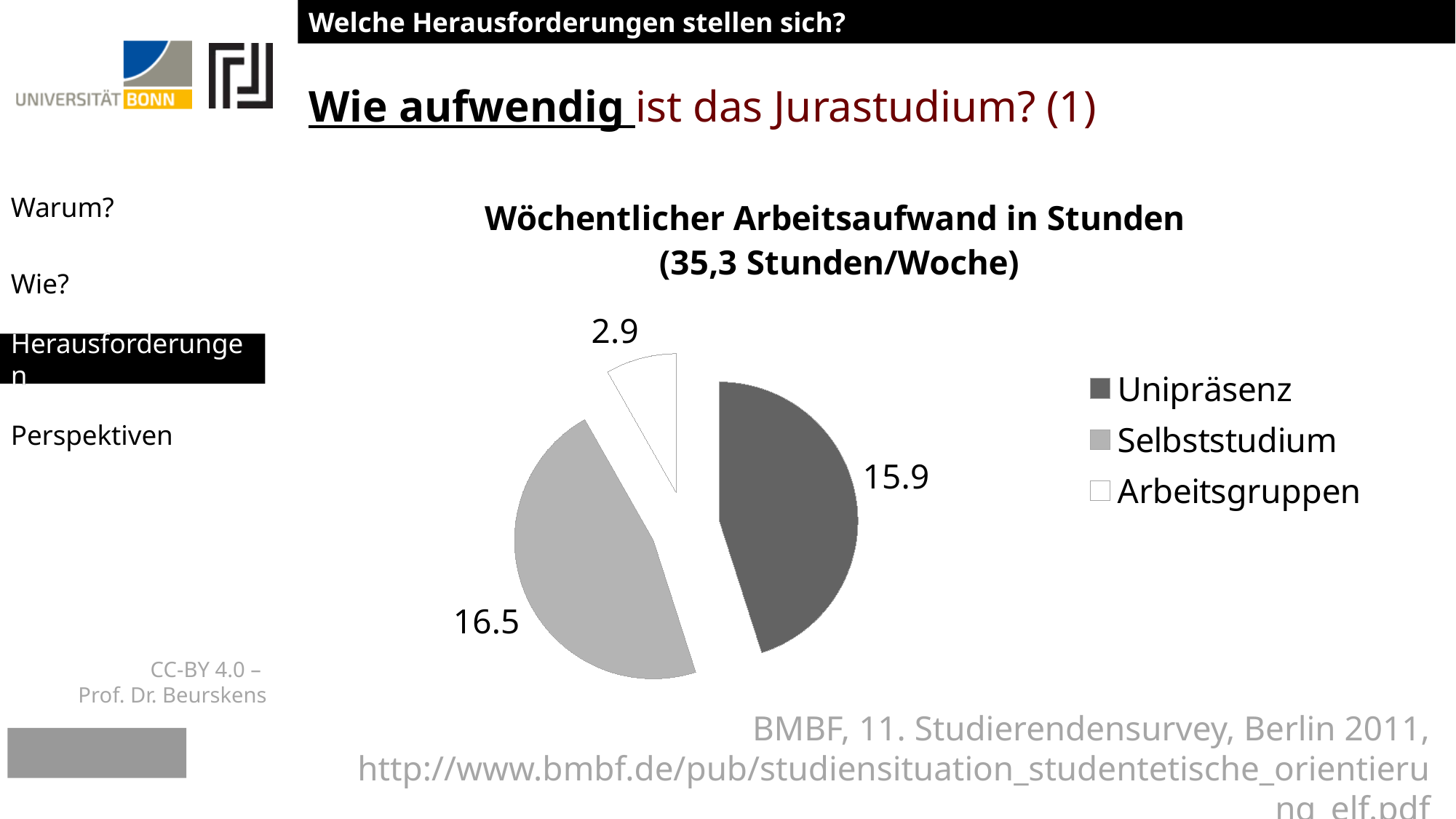
What is the total of all slices in the pie chart? 35.3 What is the value for Arbeitsgruppen? 2.9 What is the value for Unipräsenz? 15.9 Which is larger, the value for Unipräsenz or the value for Arbeitsgruppen? Unipräsenz What is the difference between the values for Selbststudium and Unipräsenz? 0.6 What type of chart is shown on the slide? pie chart How many slices does the pie chart have? 3 Which category has the largest value? Selbststudium What is the difference between the values for Unipräsenz and Arbeitsgruppen? 13.0 Which category has the smallest value? Arbeitsgruppen What is the value for Selbststudium? 16.5 What is the title of the chart? Wöchentlicher Arbeitsaufwand in Stunden (35,3 Stunden/Woche)